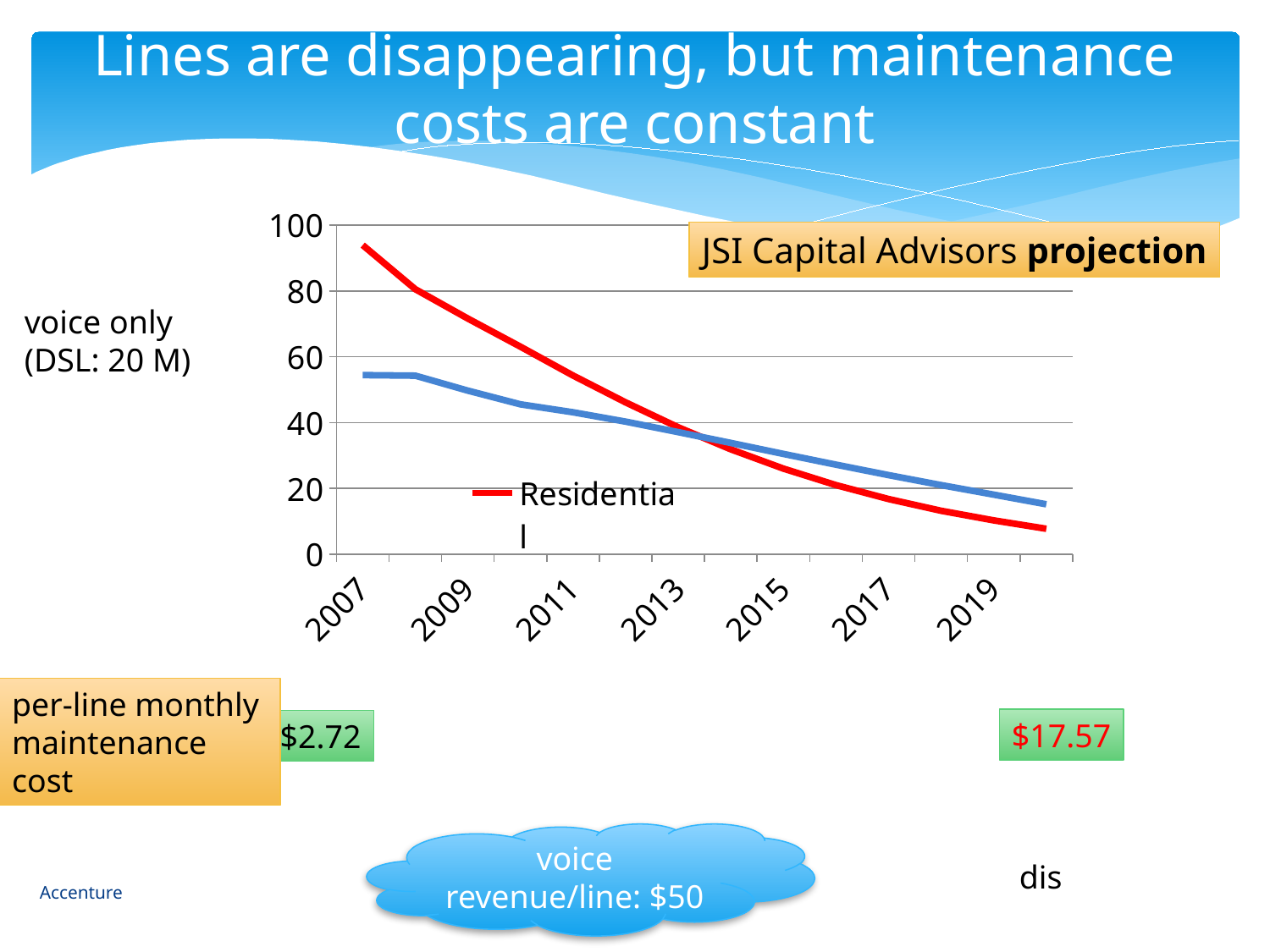
Is the Residential value in 2013 greater or less than 60? less Is the blue line's value in 2007 greater or less than 60? less How many year labels are shown on the x axis? 7 In 2007, which line is higher, the red Residential line or the blue line? the red Residential line Is the Residential value in 2019 greater or less than 20? less Does the Residential line rise or fall from 2007 to 2019? falls What kind of chart is shown on the slide? line chart Does the blue line rise or fall from 2007 to 2019? falls What series name is shown in the chart legend? Residential In 2019, which line is higher, the red Residential line or the blue line? the blue line